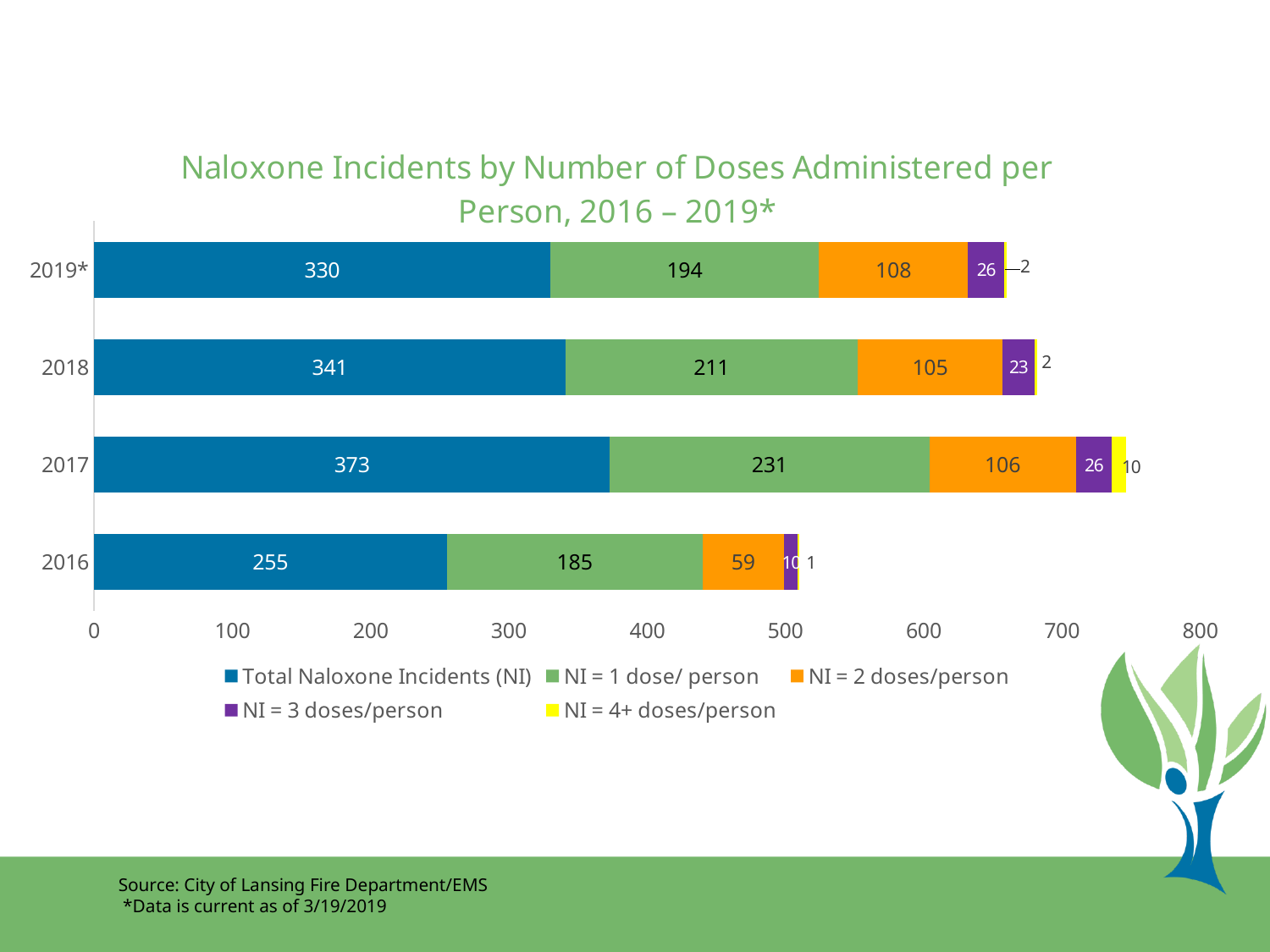
How many series does the legend list? 5 Which year has the highest Total Naloxone Incidents (NI)? 2017 What type of chart is shown on the slide? Stacked bar chart What is the value of NI = 2 doses/person for 2016? 59 How many years are shown on the chart? 4 What is the value of NI = 1 dose/ person for 2019*? 194 What is the total of all segments in the 2016 bar? 510 What is the value of NI = 4+ doses/person for 2017? 10 Which is larger: NI = 3 doses/person in 2018 or in 2019*? 2019* What is the difference between Total Naloxone Incidents (NI) in 2018 and 2016? 86 Which year has the lowest value for NI = 1 dose/ person? 2016 What is the value of Total Naloxone Incidents (NI) for 2017? 373